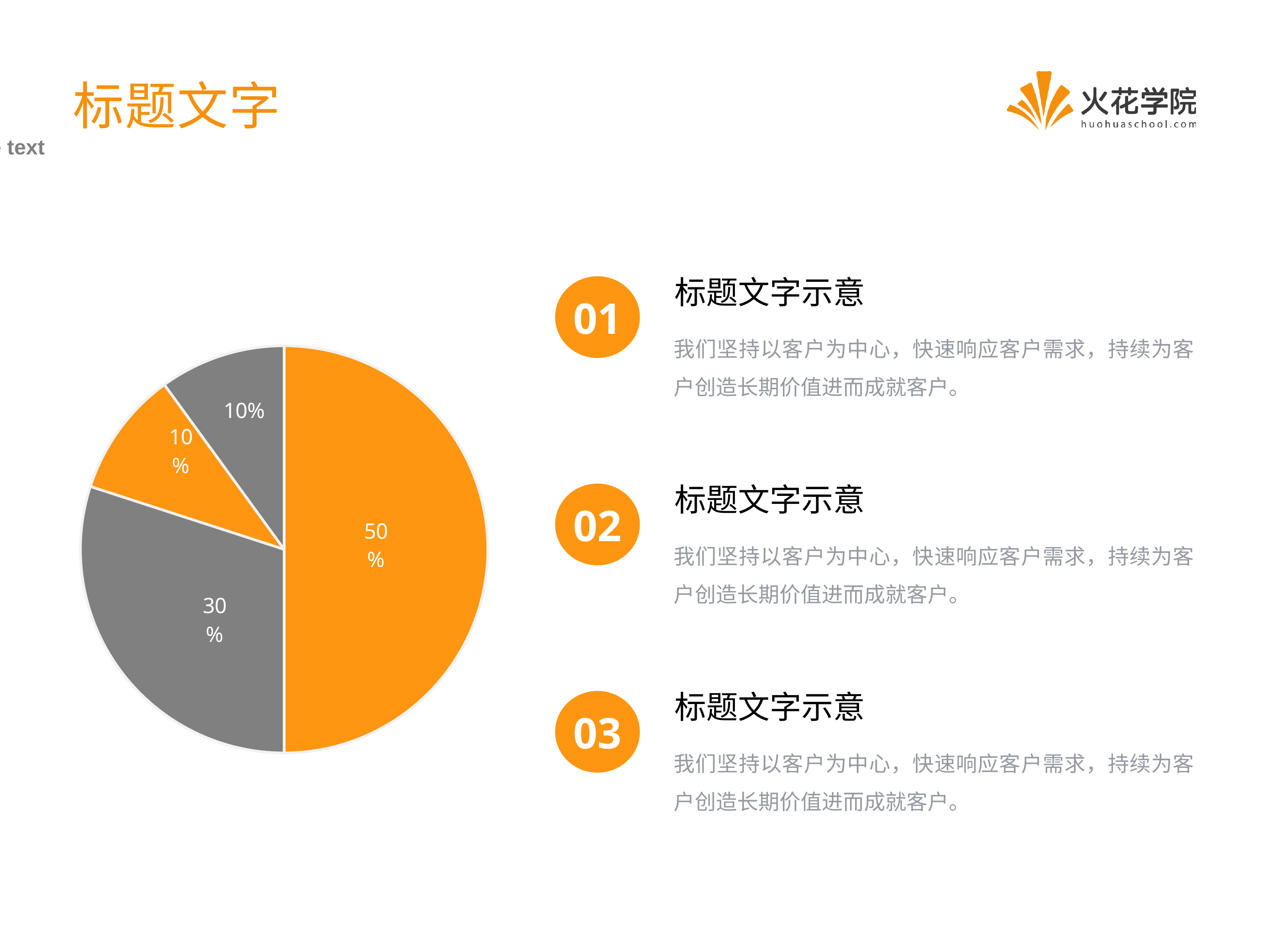
Which is larger: the orange slice on the right or the gray slice in the lower left? The orange slice on the right (50%) What value is labelled on the large gray slice in the lower left of the pie chart? 30% What is the difference between the largest slice (50%) and the gray slice labelled 30%? 20% What is the value of the smallest slice of the pie chart? 10% What share of the pie does the largest slice represent? 50% What do the two slices labelled 10% add up to? 20% What kind of chart is shown on the slide? Pie chart Which two colours are used for the slices of the pie chart? Orange and gray What value is labelled on the large orange slice on the right side of the pie chart? 50% How many slices does the pie chart have? 4 What is the value of the largest slice of the pie chart? 50% How many slices of the pie chart are labelled 10%? 2